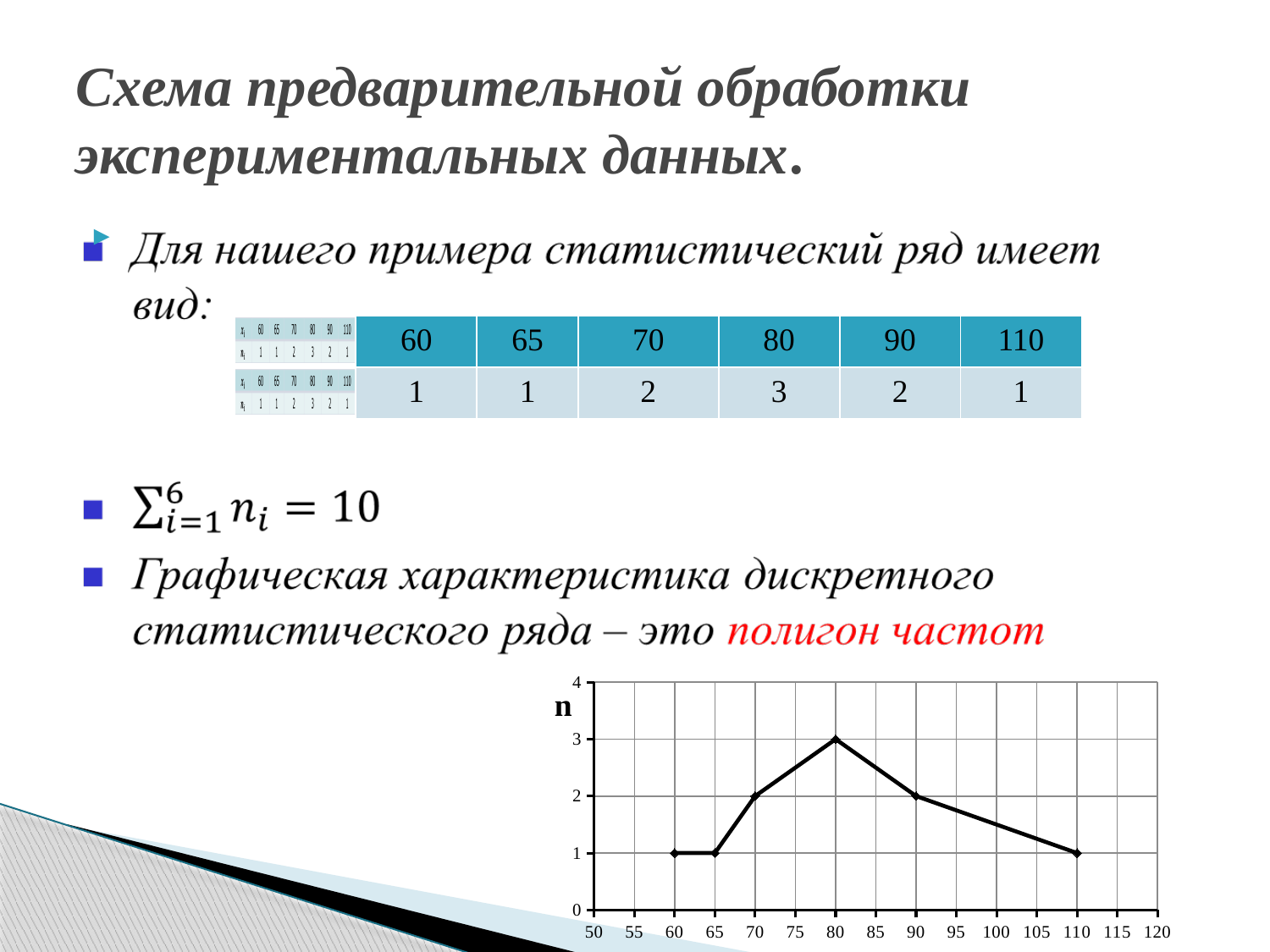
What kind of chart is shown at the bottom of the slide? line chart In the line chart, what is the value of n at x = 80? 3 In the line chart, how many data points are plotted? 6 What is the label on the vertical axis of the line chart? n In the line chart, what is the value of n at x = 70? 2 In the line chart, what is the difference between the value of n at x = 80 and at x = 60? 2 In the line chart, at which x value does n reach its highest point? 80 In the line chart, what is the value of n at x = 110? 1 What is the highest tick value shown on the vertical axis of the line chart? 4 In the line chart, which is larger: the value of n at x = 90 or at x = 110? x = 90 In the line chart, is the value of n at x = 80 greater or less than 2? greater In the line chart, does the value of n rise or fall between x = 80 and x = 110? fall